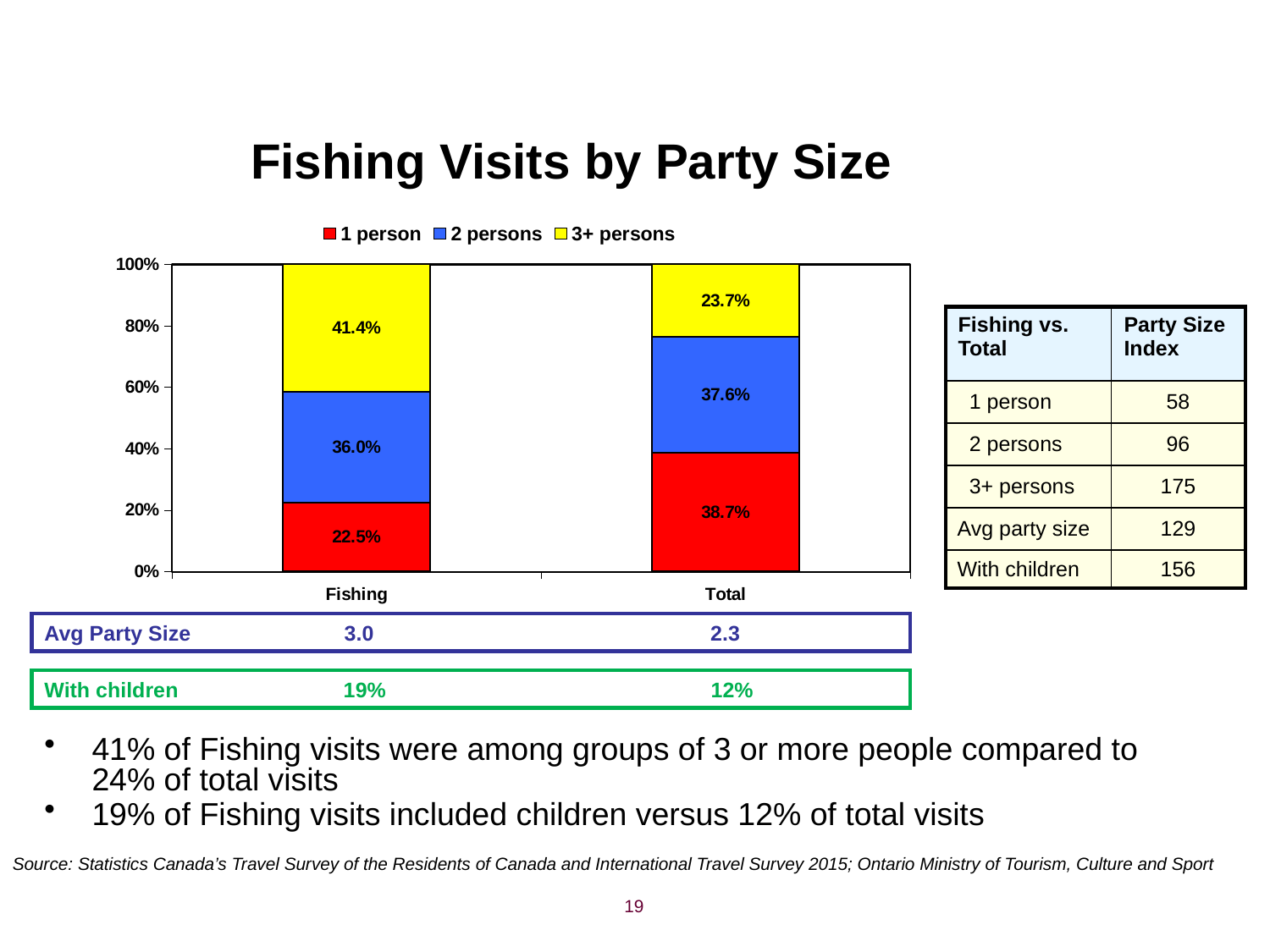
What kind of chart is shown on the slide? Stacked bar chart What is the value for 2 persons in the Total bar? 37.6% What is the difference between the 3+ persons share for Fishing and for Total? 17.7% Which party size has the smallest share of Total visits? 3+ persons How many categories are shown on the x axis? 2 How many series does the legend list? 3 What percentage of Fishing visits were by parties of 3+ persons? 41.4% Which is larger: the 1 person share for Fishing or for Total? Total What is the value for 2 persons in the Fishing bar? 36.0% Which party size has the largest share of Fishing visits? 3+ persons What colour represents the 2 persons series? Blue What percentage of Total visits were by 1 person? 38.7%